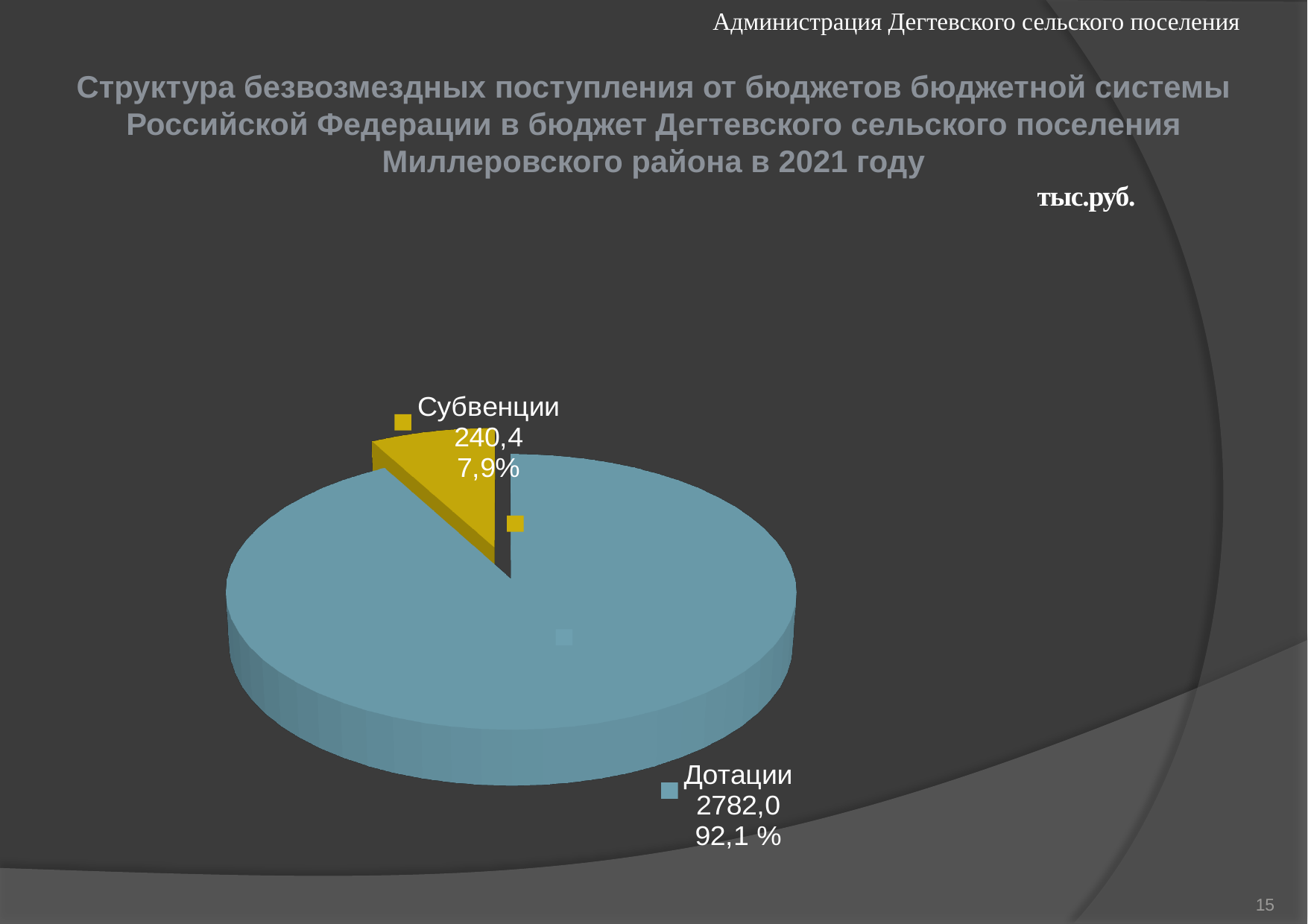
What unit is indicated for the values on the chart? тыс.руб. Which category has the smallest slice? Субвенции What colour is the Субвенции slice? yellow Which is larger, Дотации or Субвенции? Дотации What kind of chart is shown on the slide? pie chart What share of the pie does Субвенции take? 7,9% How many slices does the pie chart have? 2 What is the value for Субвенции? 240,4 What share of the pie does Дотации take? 92,1 % What is the difference between the values for Дотации and Субвенции? 2541,6 Which category has the largest slice? Дотации What is the value for Дотации? 2782,0